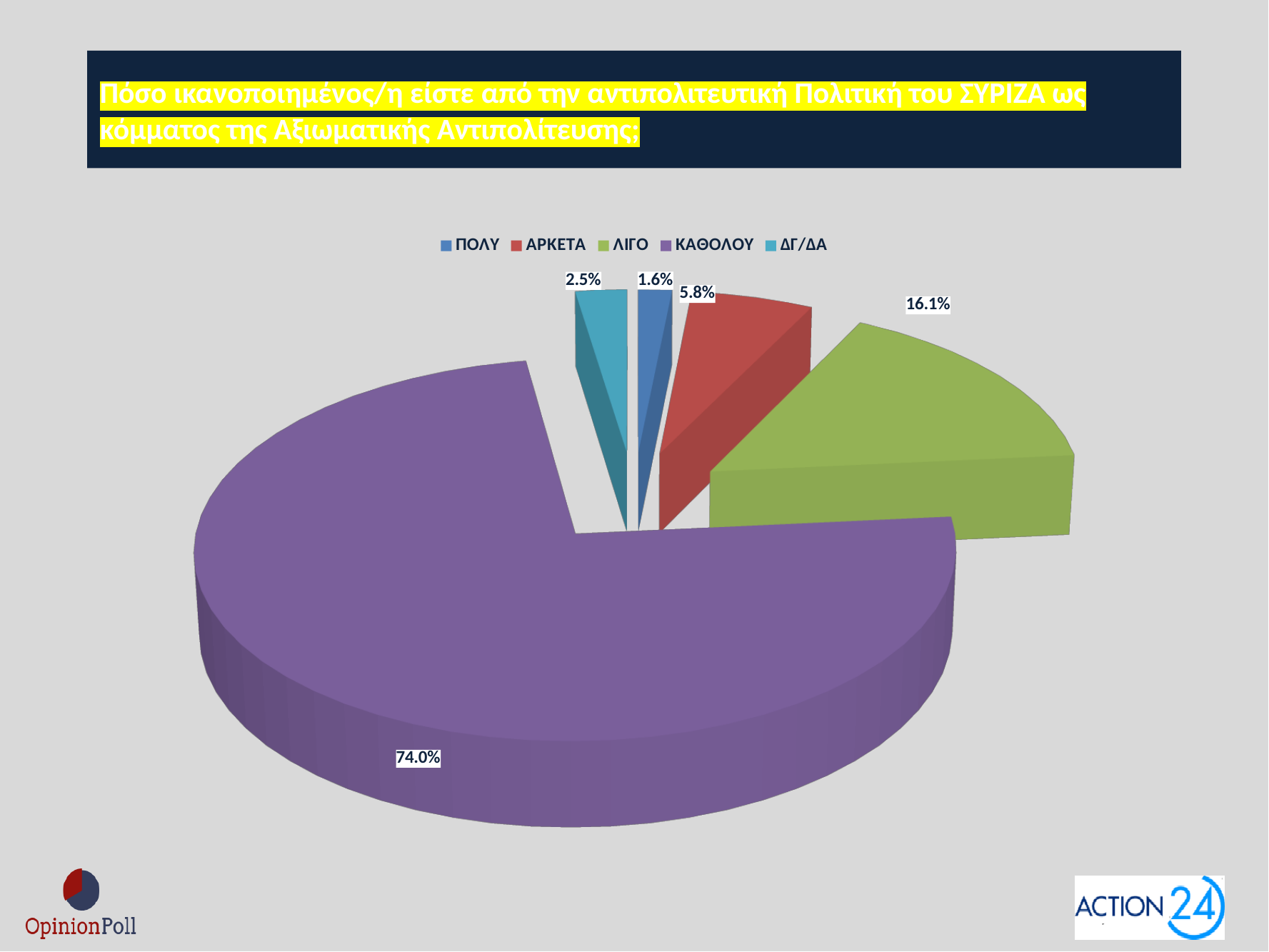
How many categories does the legend list? 5 What is the difference in percentage points between ΚΑΘΟΛΟΥ and ΛΙΓΟ? 57.9 What kind of chart is shown on the slide? pie chart What percentage is shown for ΑΡΚΕΤΑ? 5.8% What percentage is shown for ΛΙΓΟ? 16.1% What percentage is shown for ΚΑΘΟΛΟΥ? 74.0% Which is larger, the slice for ΑΡΚΕΤΑ or the slice for ΔΓ/ΔΑ? ΑΡΚΕΤΑ What percentage is shown for ΔΓ/ΔΑ? 2.5% What percentage is shown for ΠΟΛΥ? 1.6% Which category has the largest slice of the pie? ΚΑΘΟΛΟΥ Which category has the smallest slice of the pie? ΠΟΛΥ What colour is the slice for ΛΙΓΟ? green